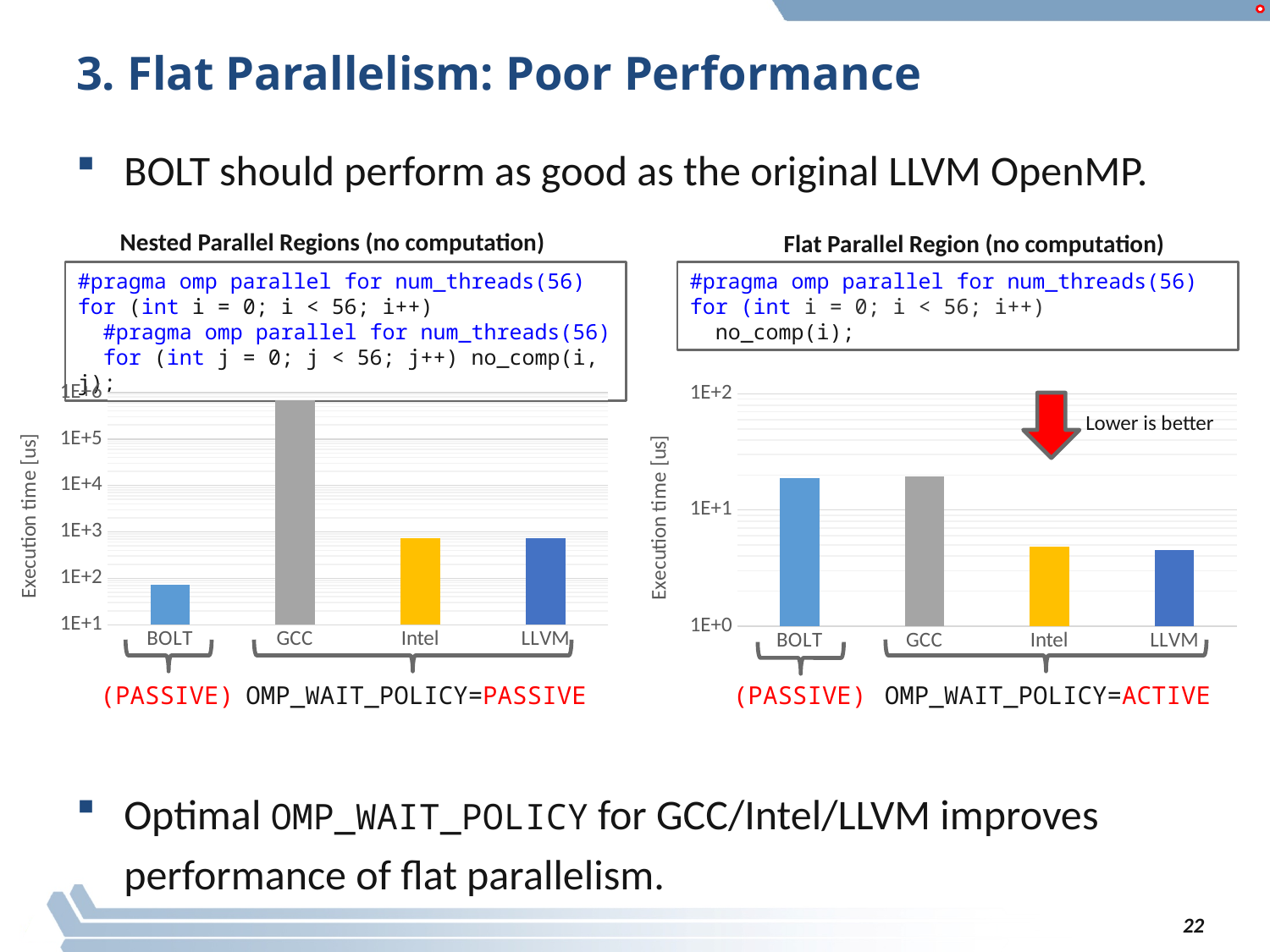
How many categories are shown on the x axis of the Flat Parallel Region (no computation) chart? 4 In the Nested Parallel Regions (no computation) chart, which category has the lowest execution time? BOLT In the Flat Parallel Region (no computation) chart, which is larger, the value for GCC or the value for LLVM? GCC In the Nested Parallel Regions (no computation) chart, is the value for Intel greater or less than 1E+4? less In the Flat Parallel Region (no computation) chart, which is larger, the value for BOLT or the value for Intel? BOLT In the Nested Parallel Regions (no computation) chart, is the value for BOLT greater or less than 1E+3? less What is the y-axis label of the Flat Parallel Region (no computation) chart? Execution time [us] In the Flat Parallel Region (no computation) chart, is the value for BOLT greater or less than 1E+1? greater In the Nested Parallel Regions (no computation) chart, which category has the highest execution time? GCC What kind of chart is the Nested Parallel Regions (no computation) chart? bar chart